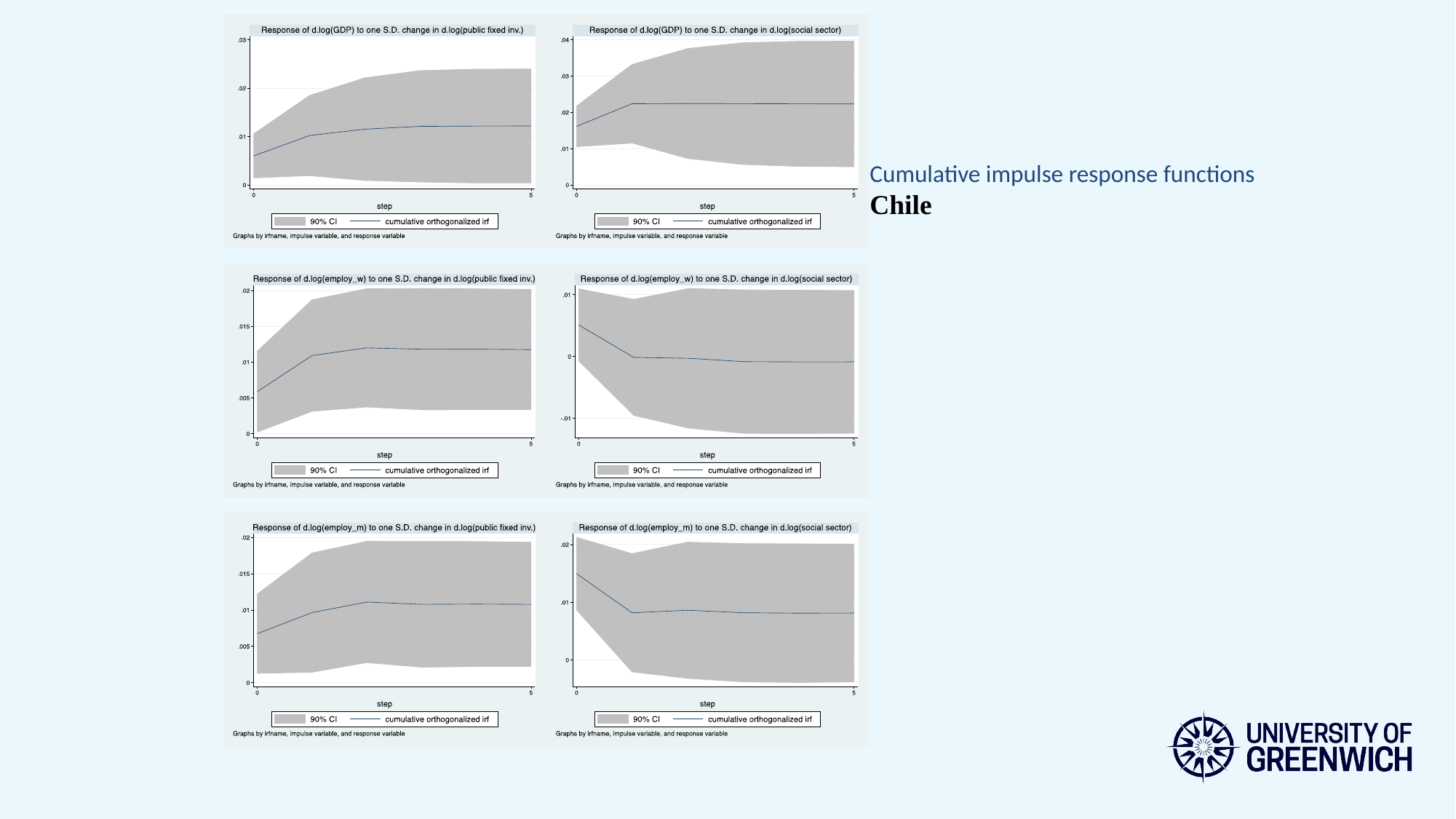
What is the x-axis label of the top-left chart, 'Response of d.log(GDP) to one S.D. change in d.log(public fixed inv.)'? step What kind of chart is the top-left chart, 'Response of d.log(GDP) to one S.D. change in d.log(public fixed inv.)'? line chart In the top-right chart, 'Response of d.log(GDP) to one S.D. change in d.log(social sector)', what does the grey shaded area represent according to the legend? 90% CI In the bottom-left chart, 'Response of d.log(employ_m) to one S.D. change in d.log(public fixed inv.)', is the cumulative orthogonalized irf value at step 0 greater or less than .01? less How many entries does the legend of the top-left chart, 'Response of d.log(GDP) to one S.D. change in d.log(public fixed inv.)', list? 2 In the top-left chart, 'Response of d.log(GDP) to one S.D. change in d.log(public fixed inv.)', is the cumulative orthogonalized irf value at step 5 greater or less than .02? less In the bottom-right chart, 'Response of d.log(employ_m) to one S.D. change in d.log(social sector)', is the cumulative orthogonalized irf value at step 0 greater or less than .01? greater In the top-left chart, 'Response of d.log(GDP) to one S.D. change in d.log(public fixed inv.)', does the cumulative orthogonalized irf line rise or fall from step 0 to step 5? rises How many charts are shown on the slide? 6 In the middle-right chart, 'Response of d.log(employ_w) to one S.D. change in d.log(social sector)', does the cumulative orthogonalized irf line rise or fall from step 0 to step 5? falls